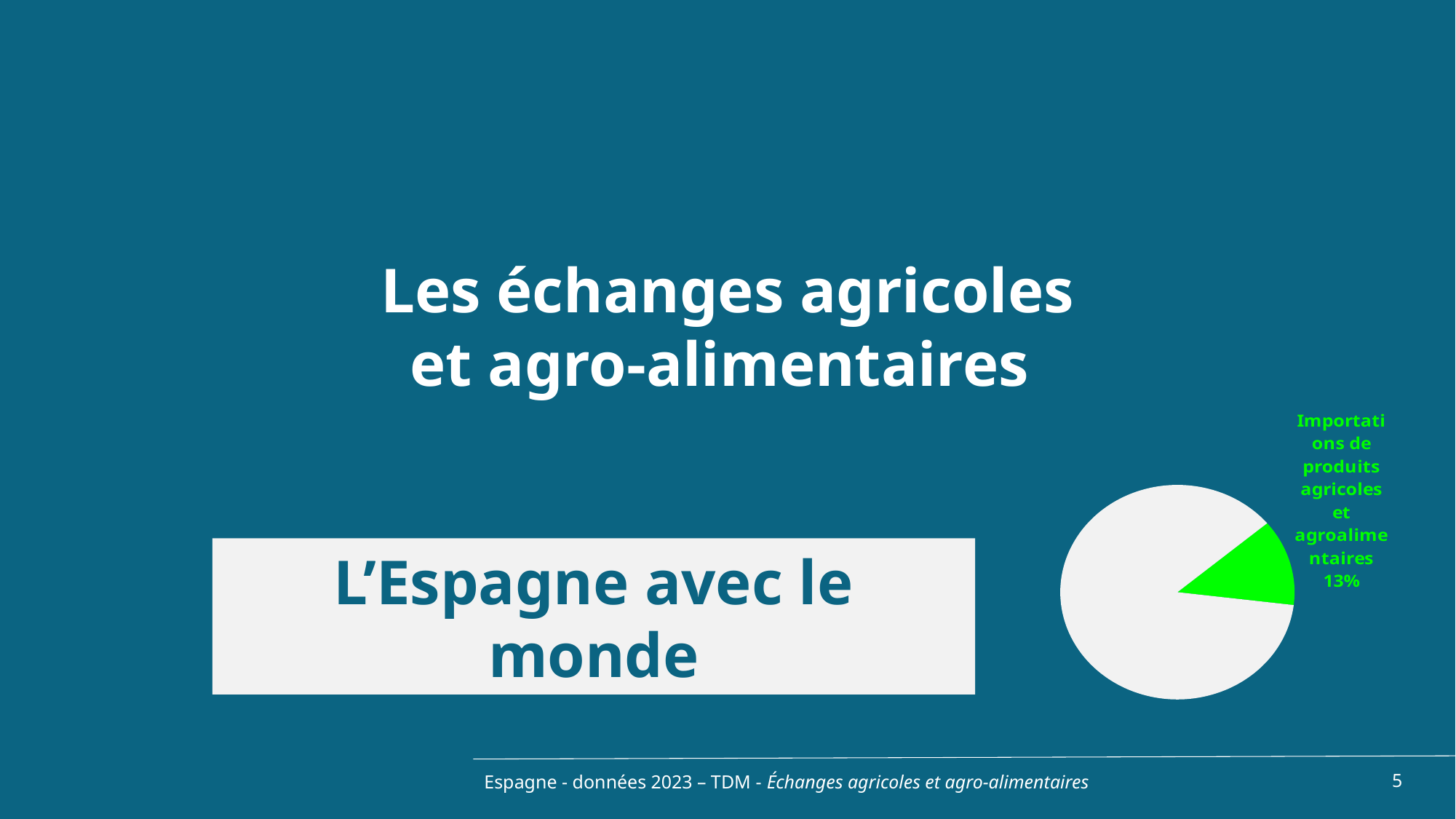
What kind of chart is shown on the slide? pie chart What value is printed on the data label of the green slice of the pie chart? 13% How many slices does the pie chart contain? 2 Is the slice for "Importations de produits agricoles et agroalimentaires" larger or smaller than the remaining unlabelled slice of the pie? smaller What share of the pie does the slice labelled "Importations de produits agricoles et agroalimentaires" represent? 13% Which slice of the pie chart is the smallest? Importations de produits agricoles et agroalimentaires What colour is the slice labelled "Importations de produits agricoles et agroalimentaires"? green Which slice of the pie chart carries a data label? Importations de produits agricoles et agroalimentaires